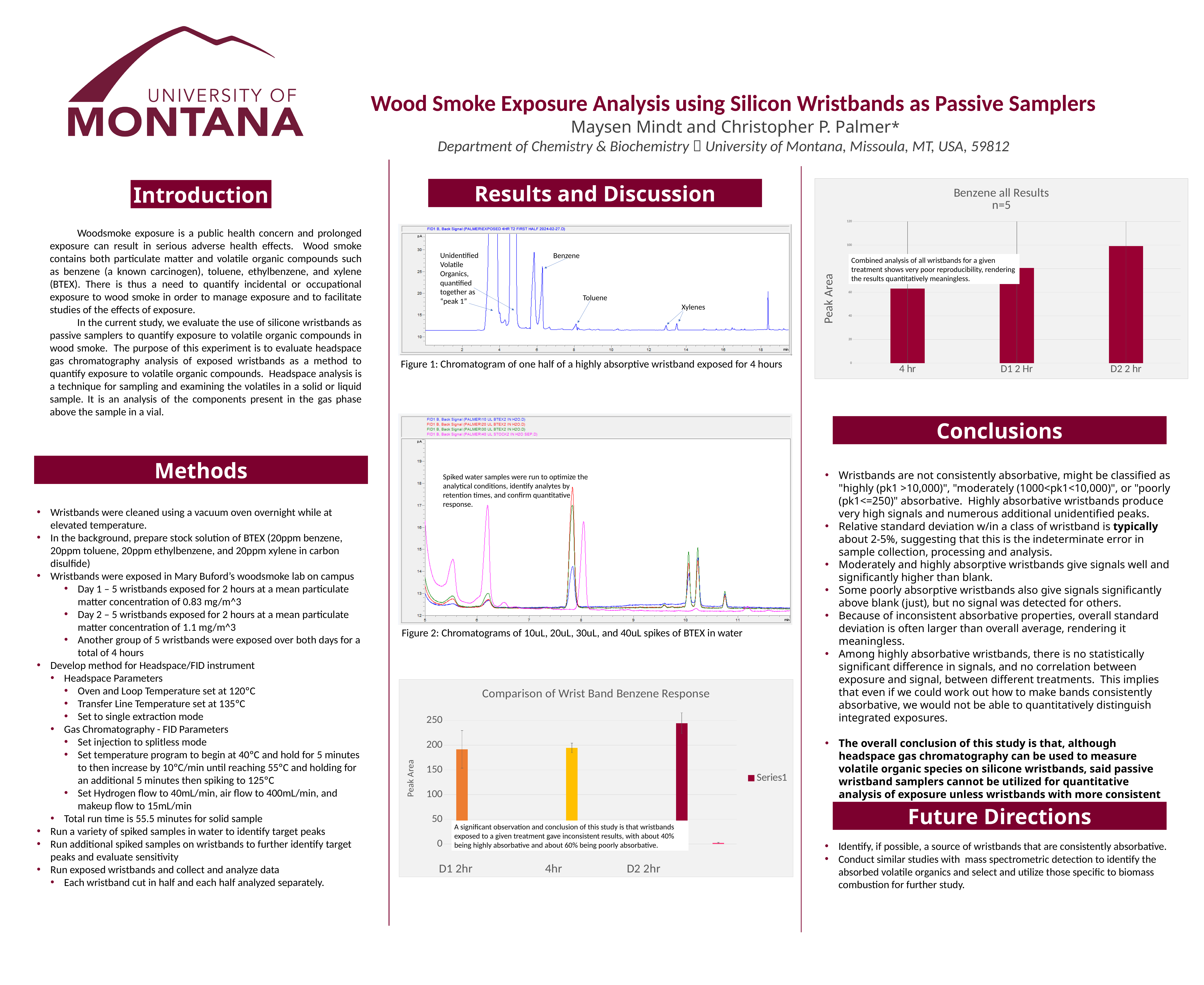
In the 'Benzene all Results' chart, is the value for D2 2 hr greater or less than 80? greater What is the subtitle shown under the title of the 'Benzene all Results' chart? n=5 In the 'Comparison of Wrist Band Benzene Response' chart, which labeled category has the highest peak area? D2 2hr What kind of chart is 'Benzene all Results'? bar chart In the 'Benzene all Results' chart, is the value for 4 hr greater or less than 80? less How many categories are shown on the x axis of the 'Benzene all Results' chart? 3 How many series does the legend of the 'Comparison of Wrist Band Benzene Response' chart list? 1 In the 'Benzene all Results' chart, which category has the lowest peak area? 4 hr In the 'Benzene all Results' chart, which category has the highest peak area? D2 2 hr In the 'Benzene all Results' chart, do the values rise or fall from left to right along the x axis? rise In the 'Comparison of Wrist Band Benzene Response' chart, is the value for D2 2hr greater or less than 200? greater